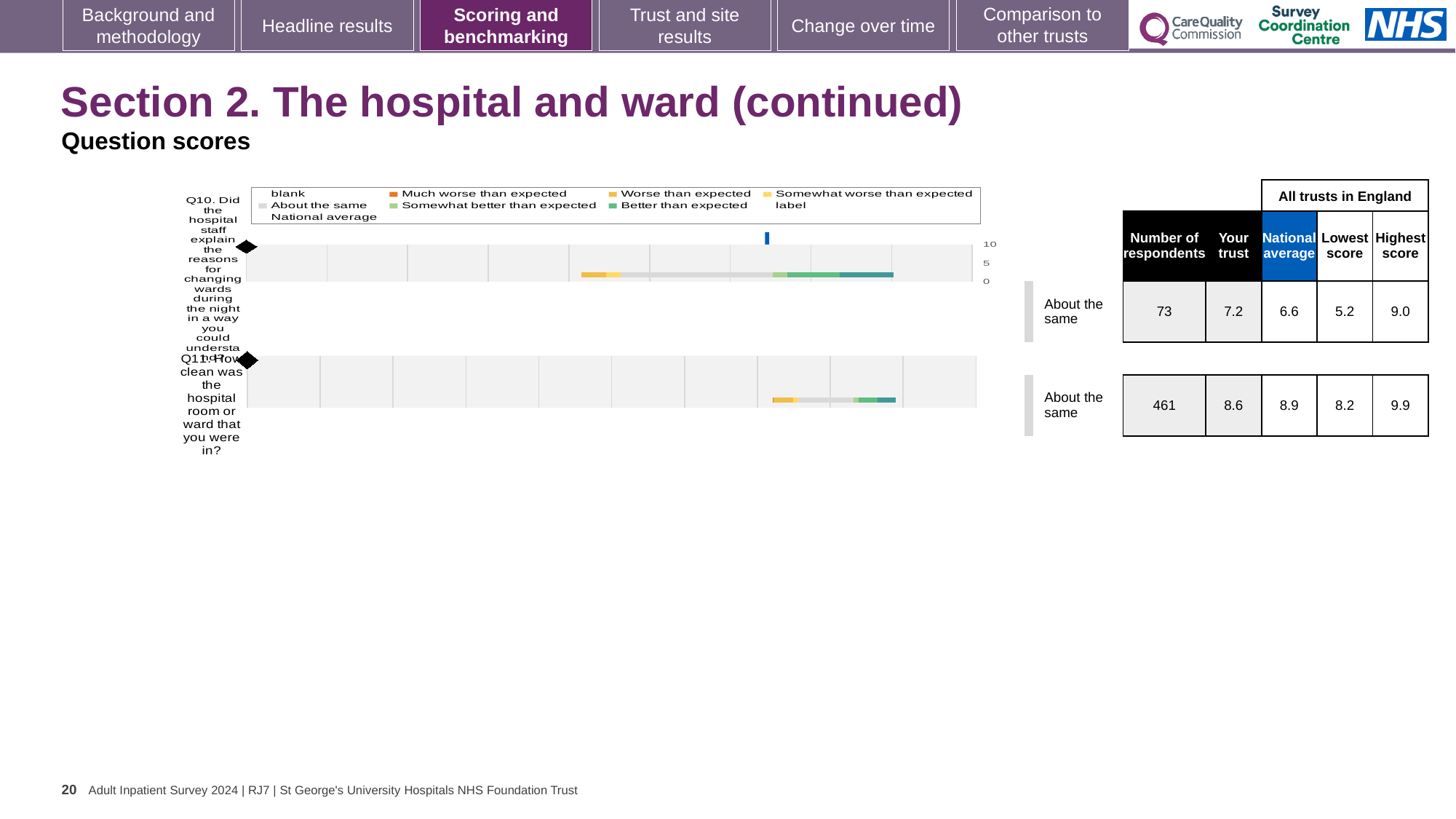
What is the 'Your trust' score for Q11 (How clean was the hospital room or ward that you were in?)? 8.6 What is the national average score for Q11? 8.9 What is the difference between the 'Your trust' score and the national average for Q10? 0.6 For Q10, which is larger: the 'Your trust' score or the national average? Your trust What is the lowest score among all trusts in England for Q10? 5.2 How many questions are plotted on the chart? 2 What is the highest tick value shown on the chart's score axis? 10 For Q11, which is larger: the 'Your trust' score or the national average? National average What is the difference between the highest score and the lowest score for Q11? 1.7 How many respondents answered Q10 (Did the hospital staff explain the reasons for changing wards during the night)? 73 What kind of chart is used to show the question scores? Bar chart What benchmark category is shown for Q11? About the same